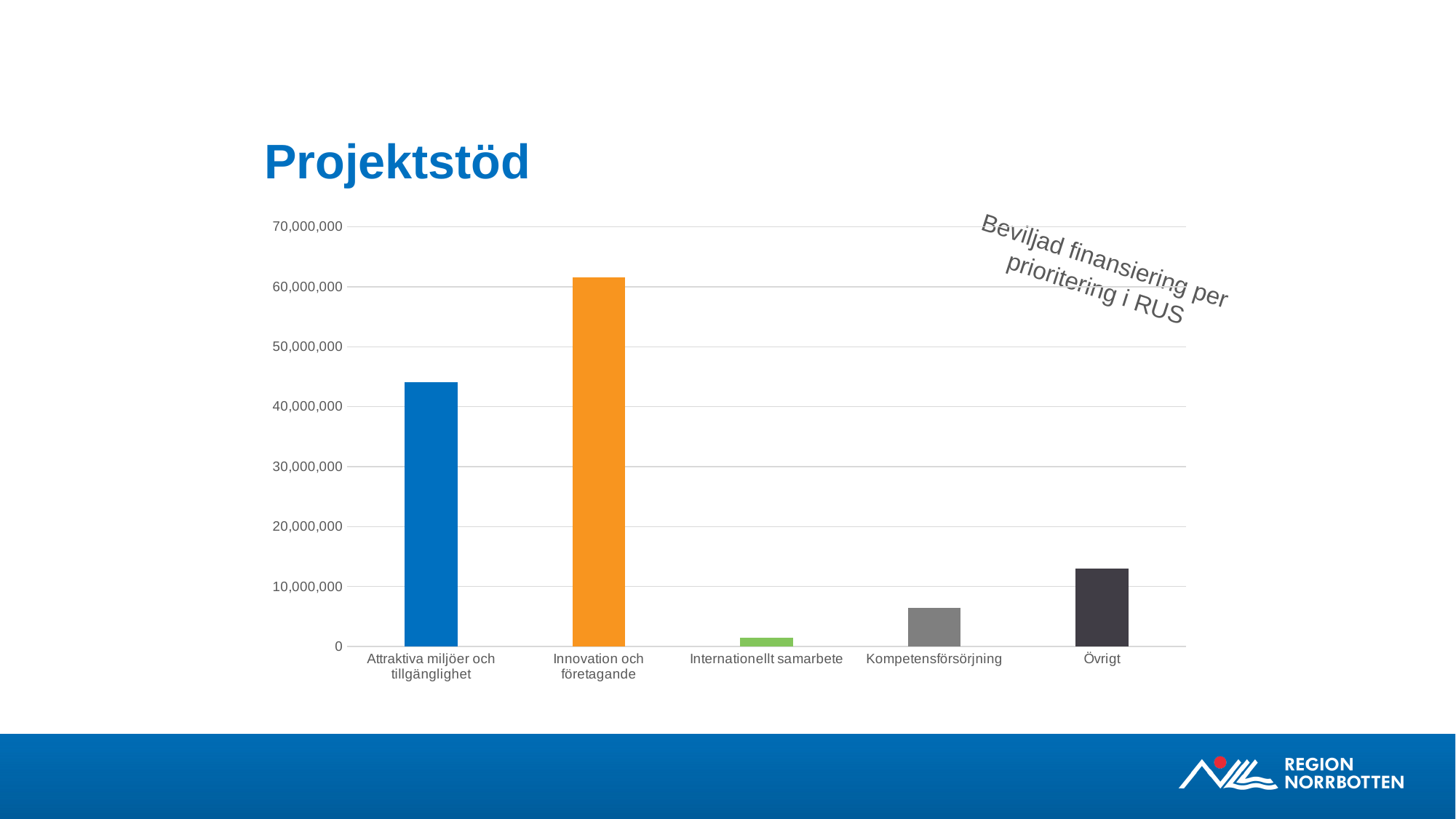
What is the title of the slide containing the chart? Projektstöd How many categories are shown on the x axis of the chart? 5 Is the value for Kompetensförsörjning greater or less than 10,000,000? less Which is larger, the value for Attraktiva miljöer och tillgänglighet or the value for Övrigt? Attraktiva miljöer och tillgänglighet Is the value for Attraktiva miljöer och tillgänglighet greater or less than 50,000,000? less Which is larger, the value for Kompetensförsörjning or the value for Internationellt samarbete? Kompetensförsörjning What kind of chart is shown on the slide? bar chart Is the value for Övrigt greater or less than 10,000,000? greater What colour is the bar for Innovation och företagande? orange Which category has the lowest value in the chart? Internationellt samarbete Which category has the highest value in the chart? Innovation och företagande